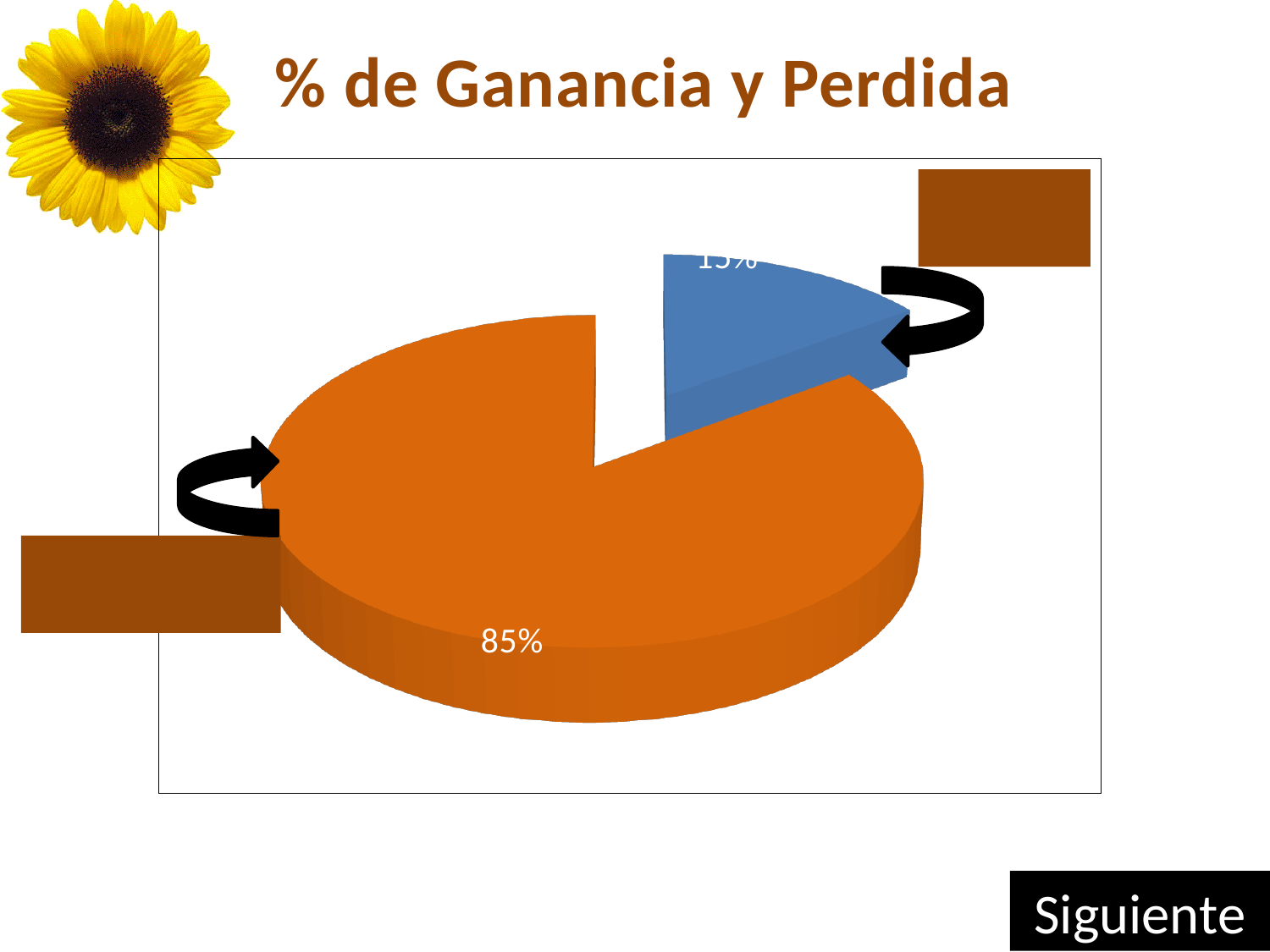
What is the value of the largest slice in the pie chart? 85% Which slice is larger, the orange one or the blue one? the orange one What share of the pie does the blue slice represent? 15% What is the value of the smallest slice in the pie chart? 15% What is the difference in percentage points between the orange slice and the blue slice? 70 What share of the pie does the orange slice represent? 85% What is the title of the chart on the slide? % de Ganancia y Perdida What kind of chart is shown on the slide? pie chart What colour is the largest slice of the pie chart? orange How many slices does the pie chart have? 2